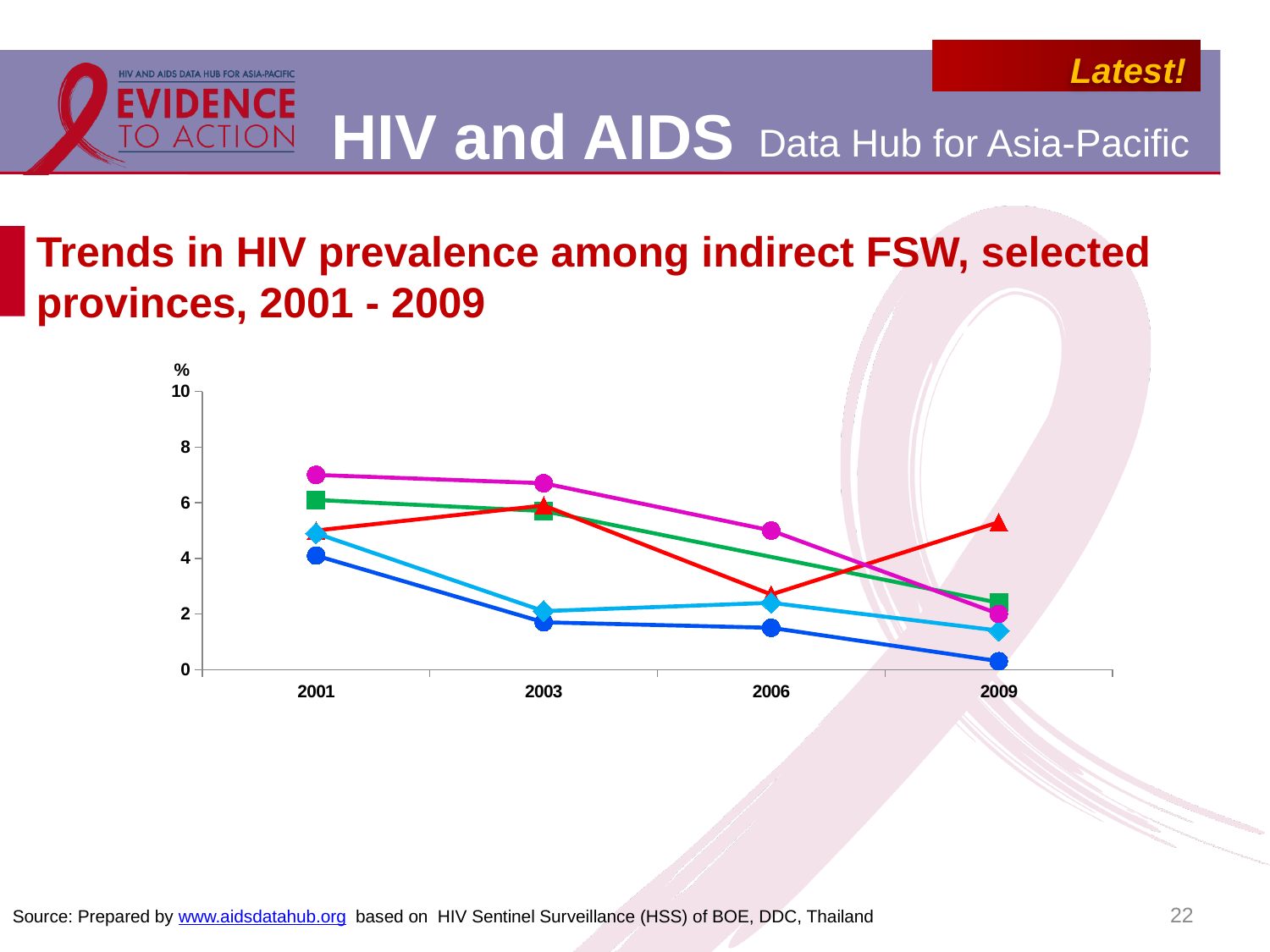
Is the value of the green line in 2001 greater or less than 4? greater What is the title of the chart on the slide? Trends in HIV prevalence among indirect FSW, selected provinces, 2001 - 2009 Is the value of the magenta (pink) line in 2001 greater or less than 6? greater Is the value of the red line in 2006 greater or less than 4? less How many years are marked on the x axis of the chart? 4 In which year does the magenta (pink) line reach its highest value? 2001 Does the magenta (pink) line rise or fall from 2001 to 2009? fall What kind of chart is shown on the slide? line chart In 2009, which is higher: the red line or the dark blue line? the red line In which year does the dark blue line reach its lowest value? 2009 What unit is shown at the top of the y axis? %